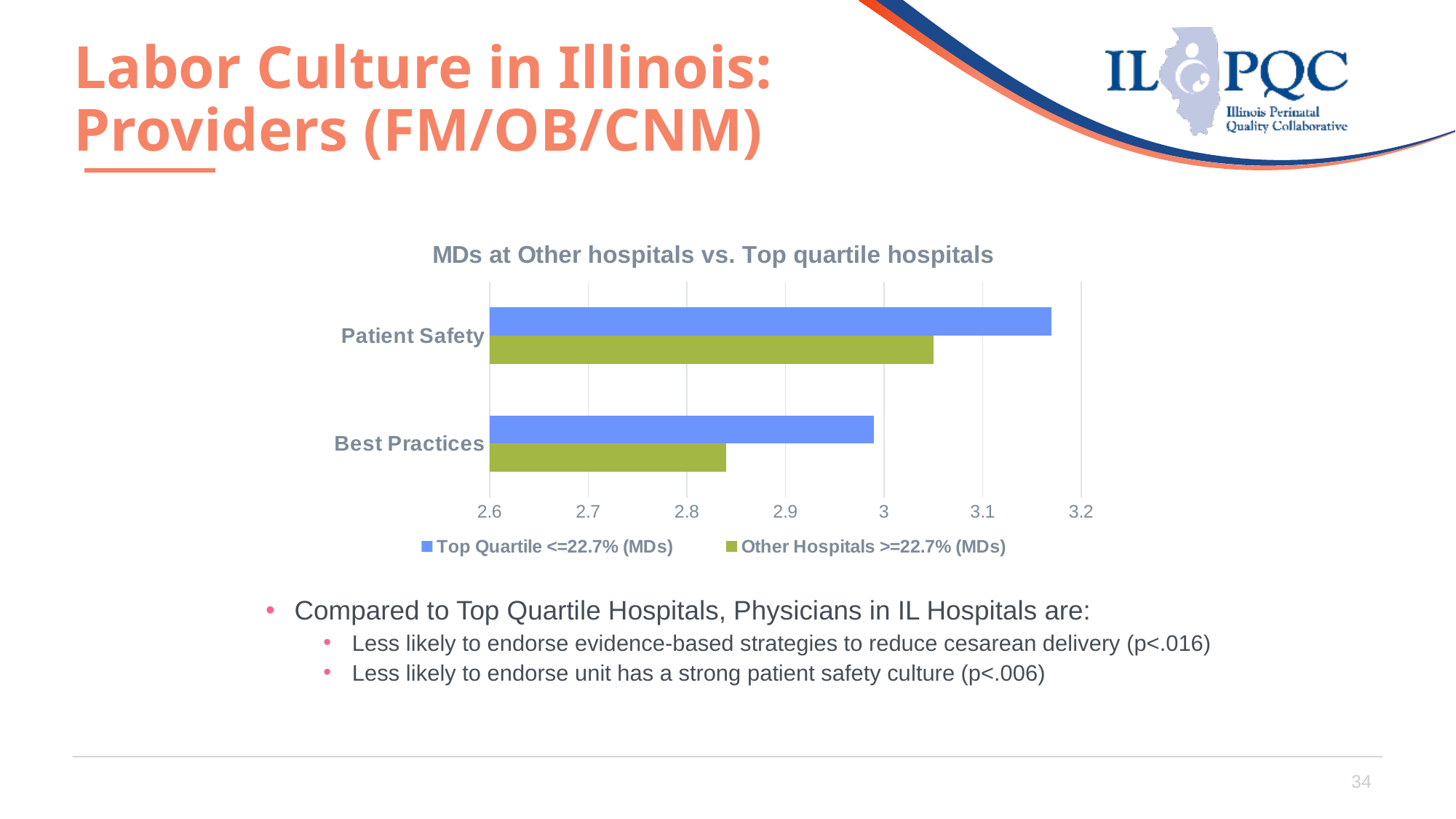
Is the Top Quartile <=22.7% (MDs) value for Patient Safety greater or less than 3.1? greater Which colour represents the Other Hospitals >=22.7% (MDs) series? Green Is the Other Hospitals >=22.7% (MDs) value for Patient Safety greater or less than 3? greater Which category has the higher Top Quartile <=22.7% (MDs) value? Patient Safety Which bar on the chart is the shortest? Other Hospitals >=22.7% (MDs) for Best Practices For Patient Safety, which series has the larger value: Top Quartile <=22.7% (MDs) or Other Hospitals >=22.7% (MDs)? Top Quartile <=22.7% (MDs) What is the title of the chart? MDs at Other hospitals vs. Top quartile hospitals Is the Other Hospitals >=22.7% (MDs) value for Best Practices greater or less than 2.9? less How many categories are shown on the chart? 2 What kind of chart is shown on the slide? Bar chart How many series does the legend list? 2